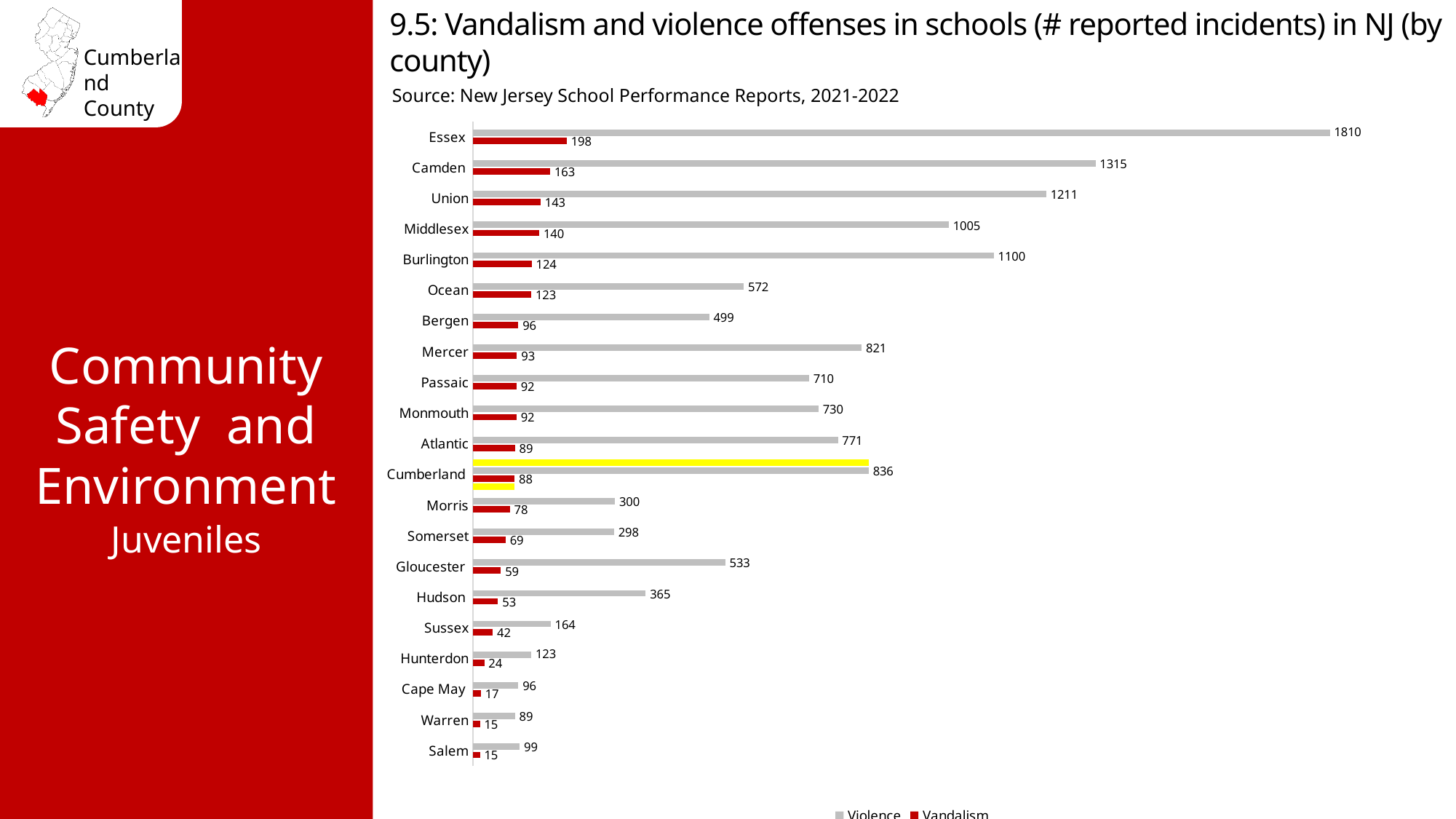
What is the number of reported vandalism incidents in Essex County? 198 What is the number of reported vandalism incidents in Hunterdon County? 24 What kind of chart is shown on the slide? Bar chart What is the difference between violence incidents in Essex and Camden? 495 Which county has more reported violence incidents, Burlington or Middlesex? Burlington How many series does the legend list? 2 What is the total of violence and vandalism incidents for Hudson County? 418 Which series is shown in red in the chart? Vandalism What is the number of reported violence incidents in Cumberland County? 836 How many counties are shown in the chart? 21 Which county has the lowest number of reported vandalism incidents? Warren and Salem (15 each) Which county has the highest number of reported violence incidents? Essex